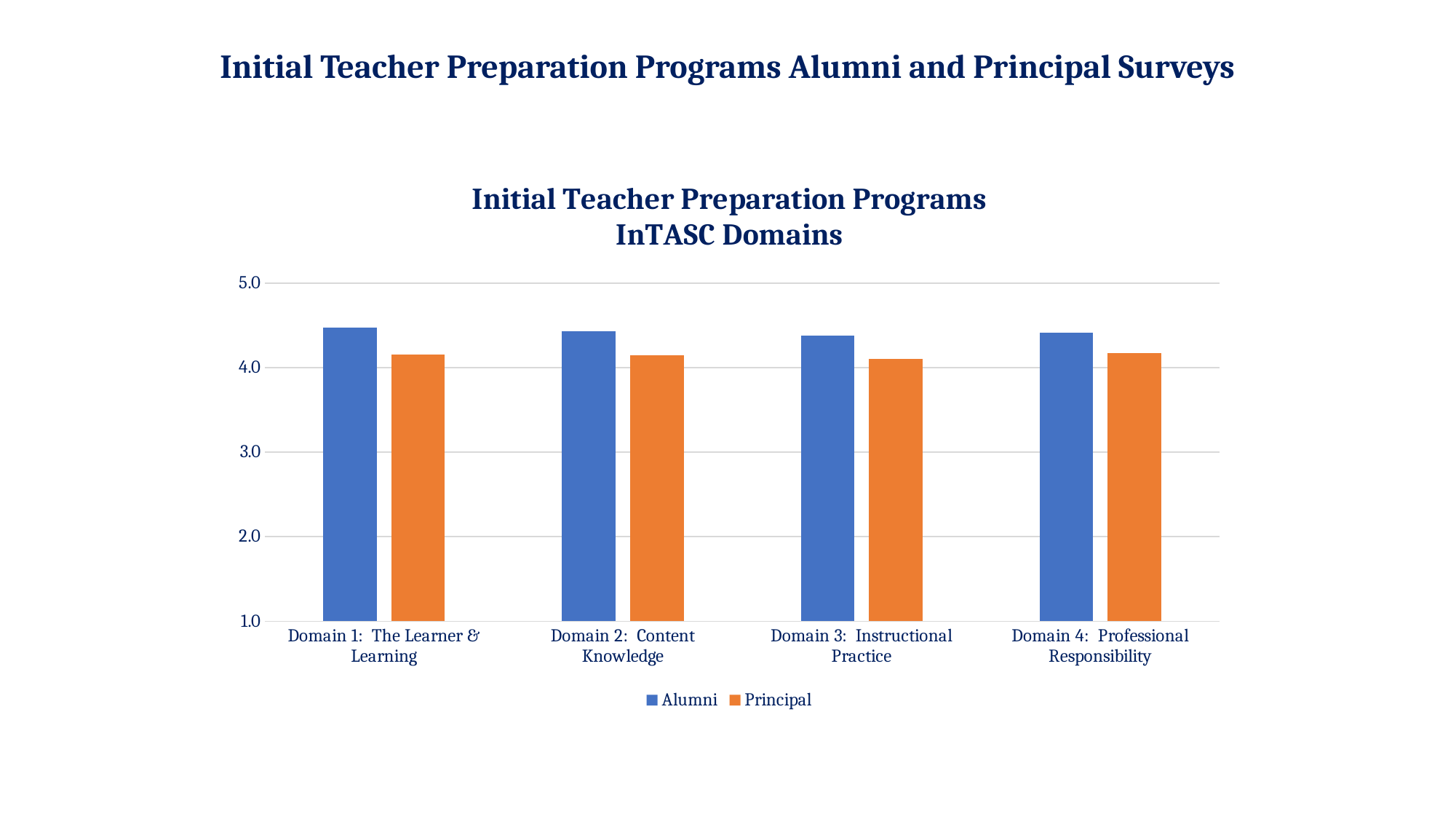
What is the title of the chart? Initial Teacher Preparation Programs InTASC Domains Is the Principal value for Domain 3: Instructional Practice greater or less than 4.0? greater Which series has the higher value for Domain 3: Instructional Practice, Alumni or Principal? Alumni Is the Alumni value for Domain 1: The Learner & Learning greater or less than 5.0? less How many domains (categories) are shown on the x axis? 4 What kind of chart is shown on the slide? bar chart Is the Principal value for Domain 4: Professional Responsibility greater or less than 3.0? greater Which colour represents the Principal series in the chart? orange How many series does the legend list? 2 Which series has the higher value for Domain 4: Professional Responsibility, Alumni or Principal? Alumni Which series has the higher value for Domain 1: The Learner & Learning, Alumni or Principal? Alumni